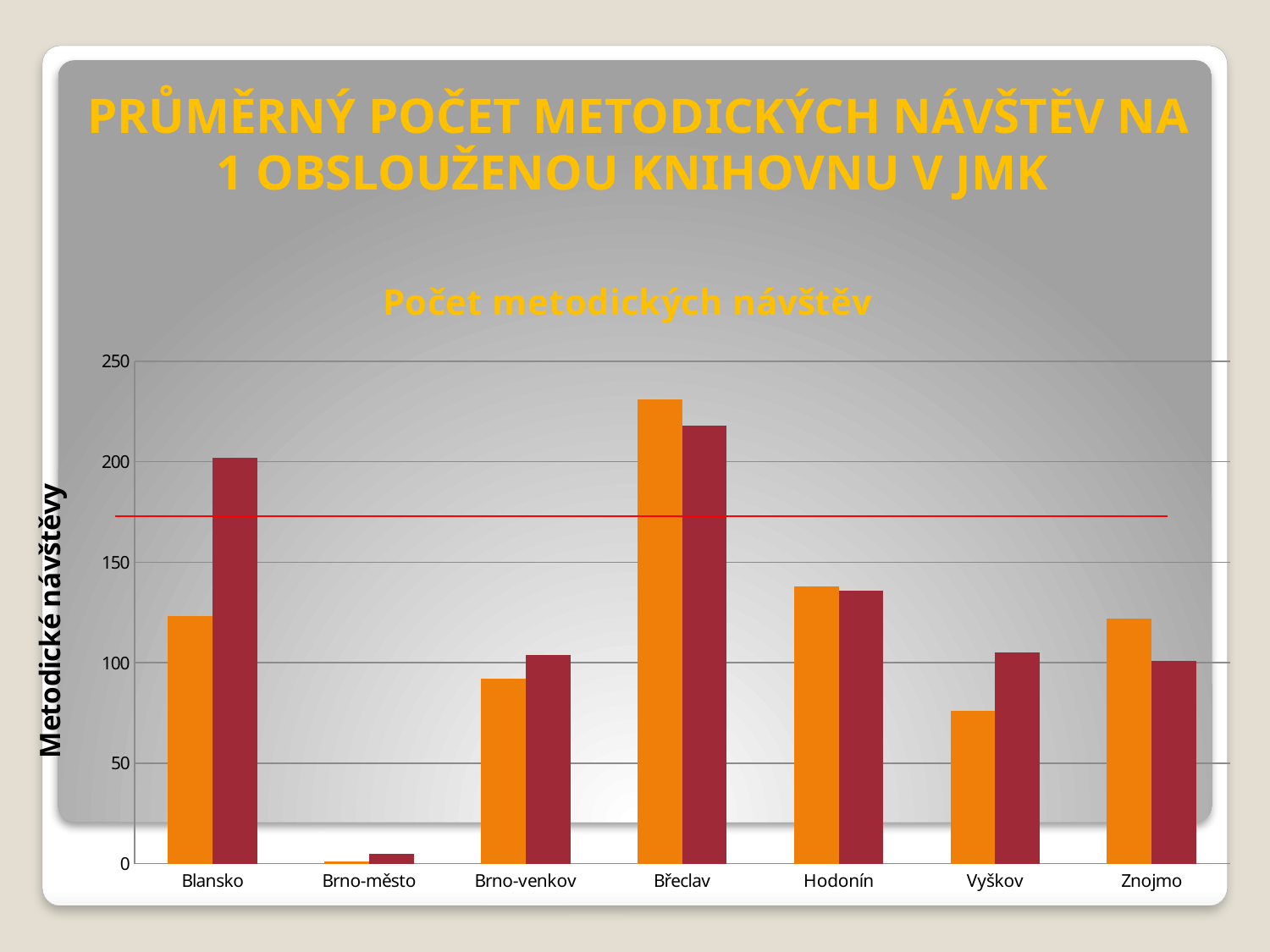
What kind of chart is shown on the slide? bar chart Which category has the highest orange bar? Břeclav For Znojmo, which bar is taller, the orange bar or the dark red bar? the orange bar Which category has the lowest dark red bar? Brno-město Is the orange bar for Břeclav greater or less than 200? greater Is the orange bar for Vyškov greater or less than 100? less Is the orange bar for Brno-město greater or less than 50? less For Blansko, which bar is taller, the orange bar or the dark red bar? the dark red bar What is the title of the chart? Počet metodických návštěv How many categories are shown on the x axis of the chart? 7 What is the label of the vertical axis? Metodické návštěvy